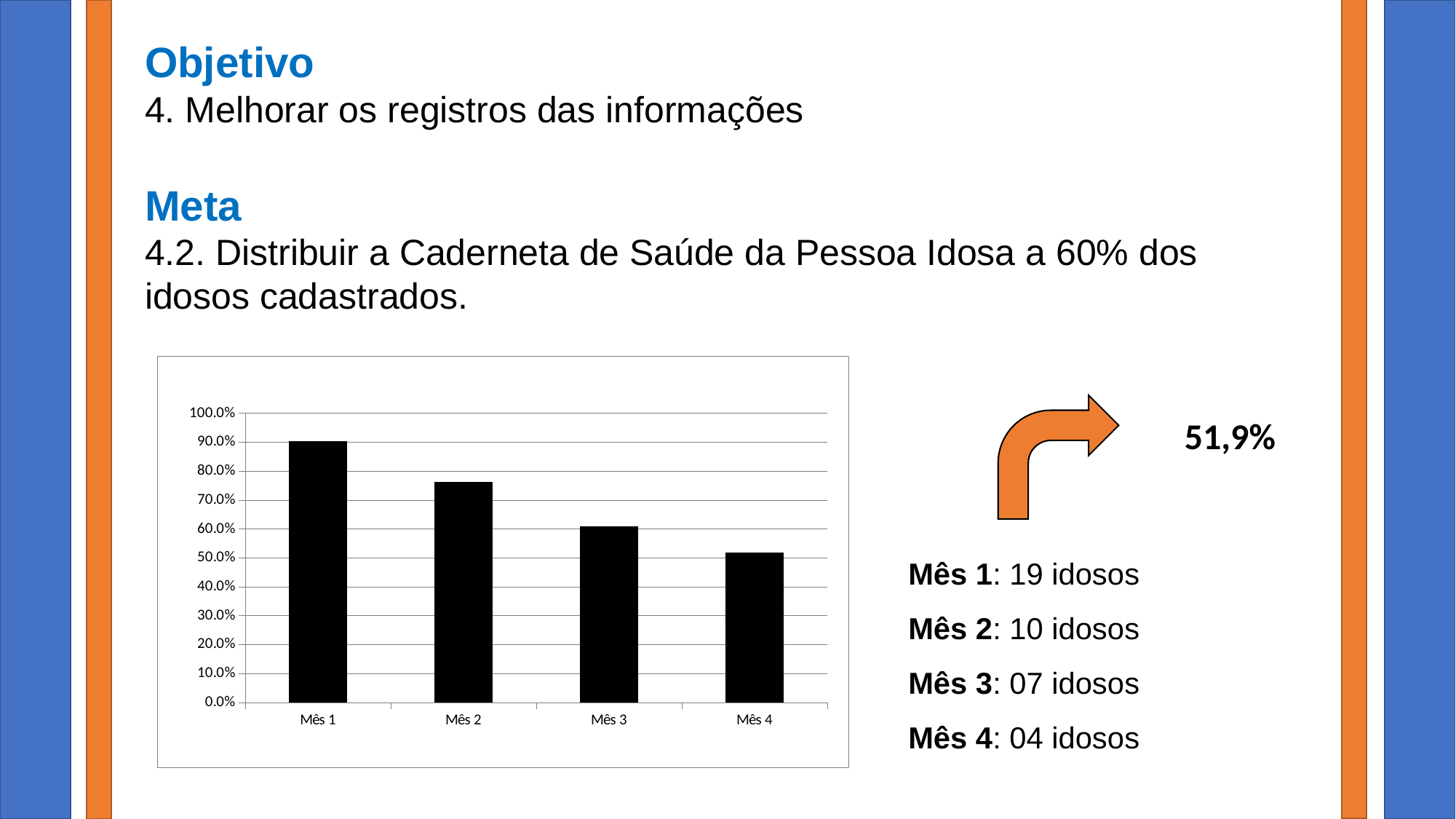
Is the value for Mês 3 greater or less than 50.0%? greater Is the value for Mês 2 greater or less than 70.0%? greater How many categories are shown on the x axis of the chart? 4 Which is larger, the value for Mês 1 or the value for Mês 3? Mês 1 Do the bar values rise or fall from Mês 1 to Mês 4? fall Which month has the lowest bar in the chart? Mês 4 What colour are the bars in the chart? black Which is larger, the value for Mês 2 or the value for Mês 4? Mês 2 Is the value for Mês 1 greater or less than 80.0%? greater What kind of chart is shown on the slide? bar chart Which month has the highest bar in the chart? Mês 1